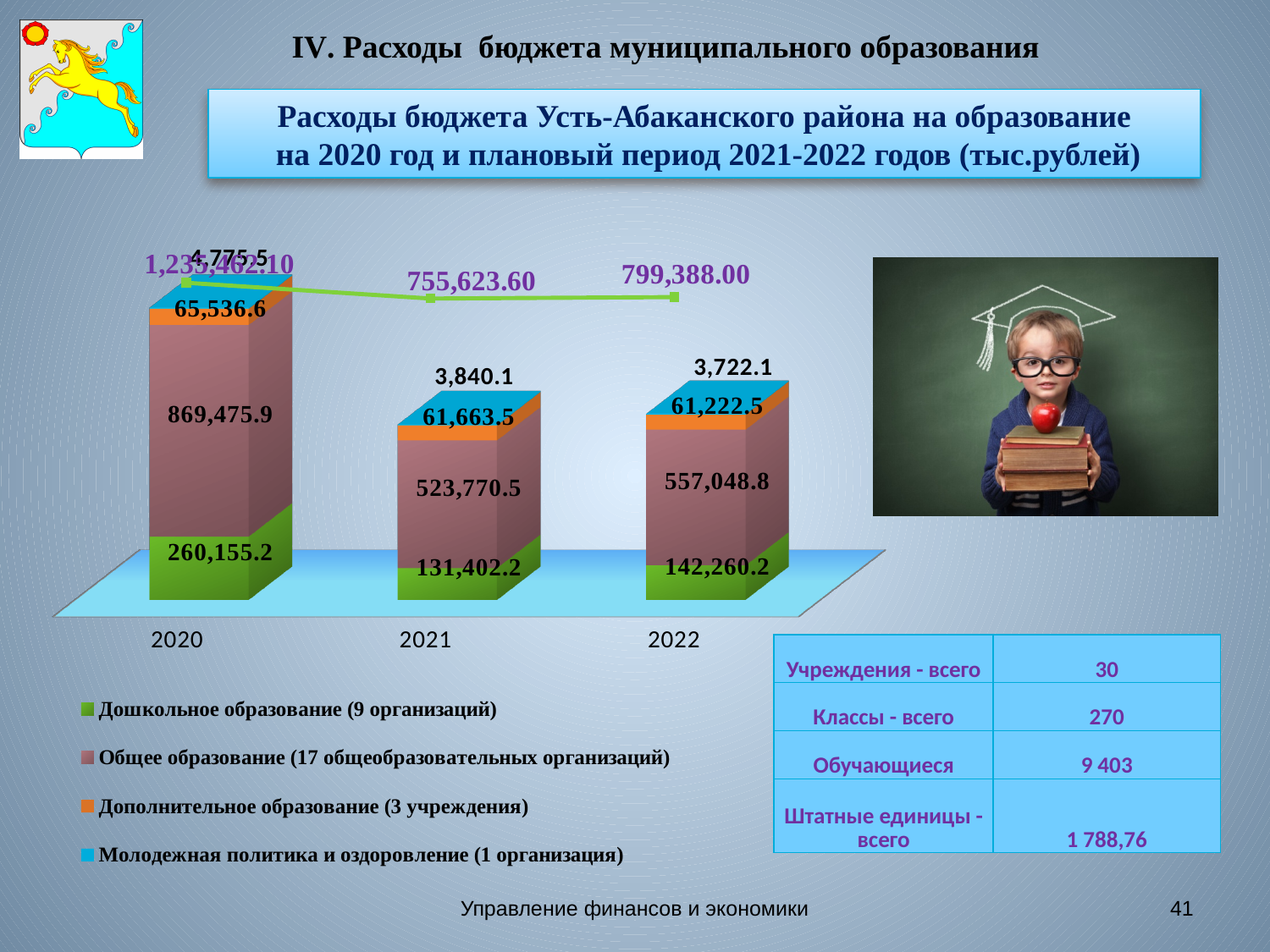
What is the difference between the Общее образование values for 2022 and 2021? 33,278.3 Which year has the larger value for Дополнительное образование, 2021 or 2022? 2021 What is the value for Молодежная политика и оздоровление in 2021? 3,840.1 What kind of chart is used to show the education expenditures? Stacked bar chart In which year is the value for Дошкольное образование the lowest? 2021 How many years are shown on the x axis of the chart? 3 How many series does the legend list? 4 What is the value for Общее образование in 2021? 523,770.5 What value does the line series show for 2022? 799,388.00 What is the value for Дополнительное образование in 2022? 61,222.5 What is the value for Дошкольное образование in 2020? 260,155.2 In which year is the value for Общее образование the highest? 2020